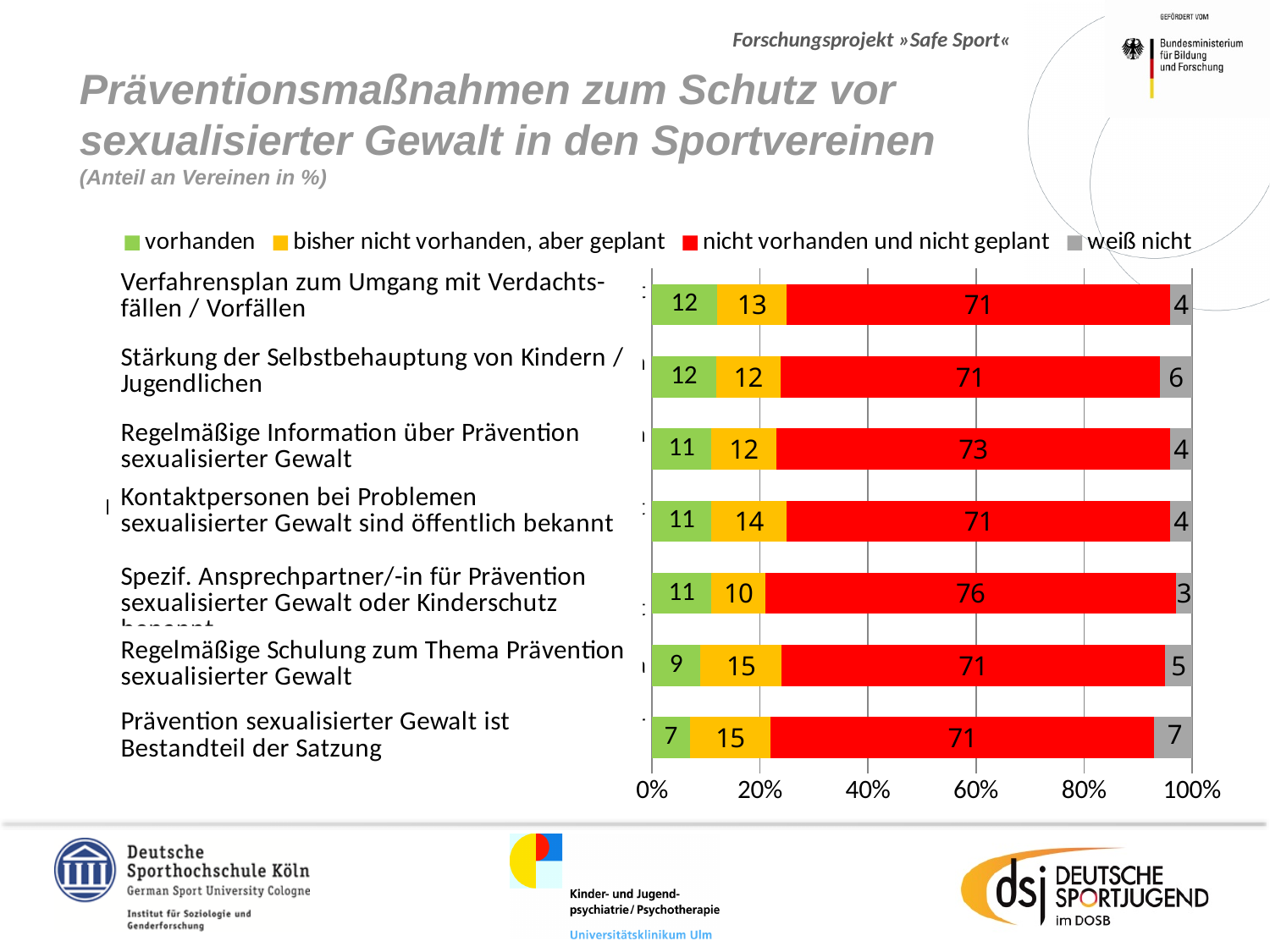
What is the total of the stacked bar for "Verfahrensplan zum Umgang mit Verdachtsfällen / Vorfällen"? 100 What is the value for "vorhanden" for "Verfahrensplan zum Umgang mit Verdachtsfällen / Vorfällen"? 12 How many series does the legend list? 4 Which category has the lowest value for "vorhanden"? Prävention sexualisierter Gewalt ist Bestandteil der Satzung What kind of chart is shown on the slide? Stacked bar chart What is the value for "bisher nicht vorhanden, aber geplant" for "Regelmäßige Schulung zum Thema Prävention sexualisierter Gewalt"? 15 Which has the larger "bisher nicht vorhanden, aber geplant" value: "Regelmäßige Schulung zum Thema Prävention sexualisierter Gewalt" or "Spezif. Ansprechpartner/-in für Prävention sexualisierter Gewalt oder Kinderschutz"? Regelmäßige Schulung zum Thema Prävention sexualisierter Gewalt How many categories (bars) are shown in the chart? 7 What is the value for "weiß nicht" for "Prävention sexualisierter Gewalt ist Bestandteil der Satzung"? 7 What is the value for "nicht vorhanden und nicht geplant" for "Spezif. Ansprechpartner/-in für Prävention sexualisierter Gewalt oder Kinderschutz"? 76 Which category has the highest value for "nicht vorhanden und nicht geplant"? Spezif. Ansprechpartner/-in für Prävention sexualisierter Gewalt oder Kinderschutz What is the difference between the "vorhanden" values for "Verfahrensplan zum Umgang mit Verdachtsfällen / Vorfällen" and "Prävention sexualisierter Gewalt ist Bestandteil der Satzung"? 5